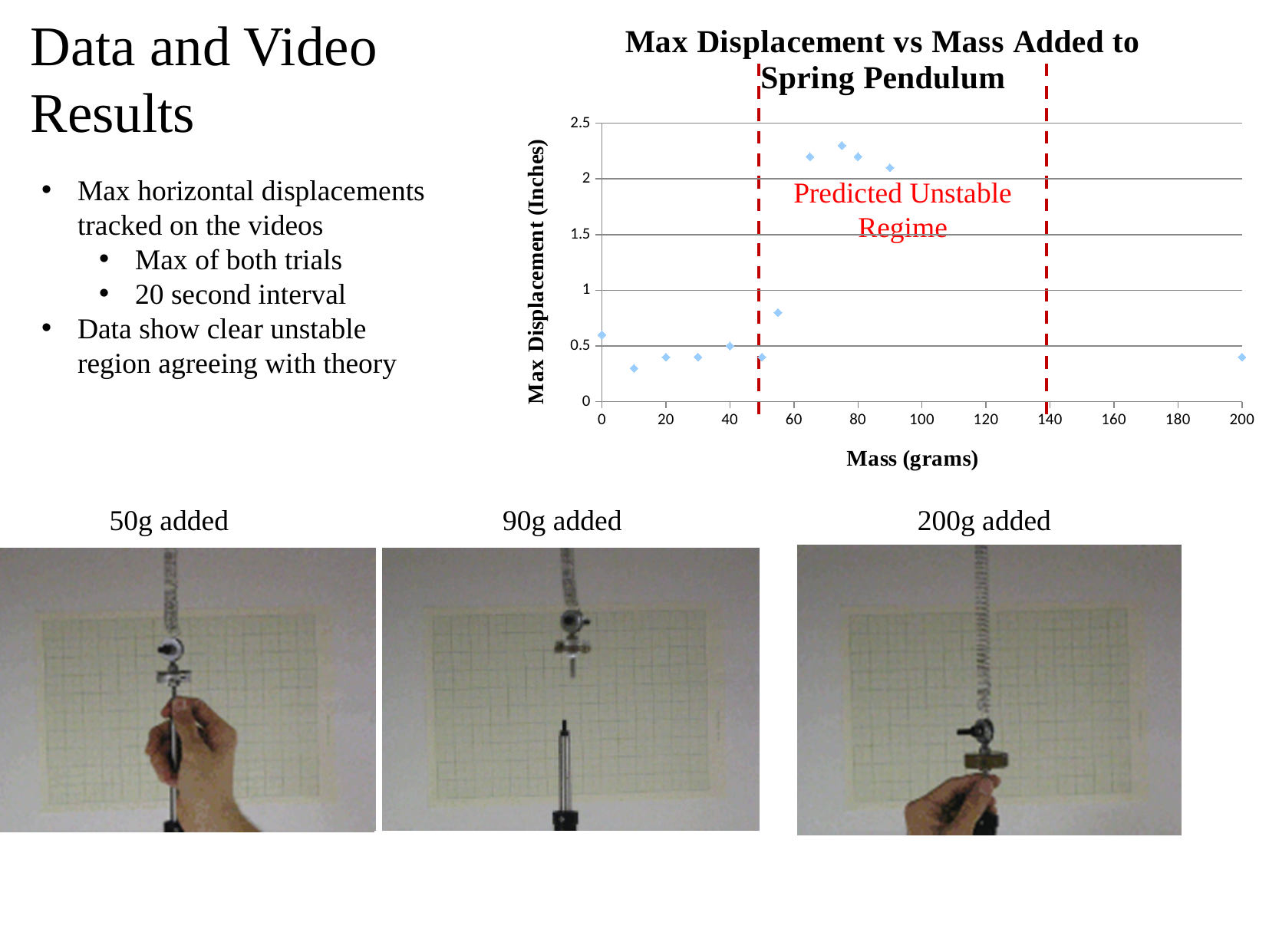
Is the max displacement at 75 grams greater or less than 2 inches? greater Which has the larger max displacement: 200 grams or 75 grams? 75 grams Is the max displacement at 0 grams greater or less than 1 inch? less Is the max displacement at 200 grams greater or less than 1 inch? less What is the label of the y axis of the chart? Max Displacement (Inches) Between 55 grams and 75 grams, do the max displacement values rise or fall? rise How many data points are plotted on the chart? 12 What type of chart is shown on the slide? scatter chart What is the title of the chart? Max Displacement vs Mass Added to Spring Pendulum Which has the larger max displacement: 65 grams or 50 grams? 65 grams